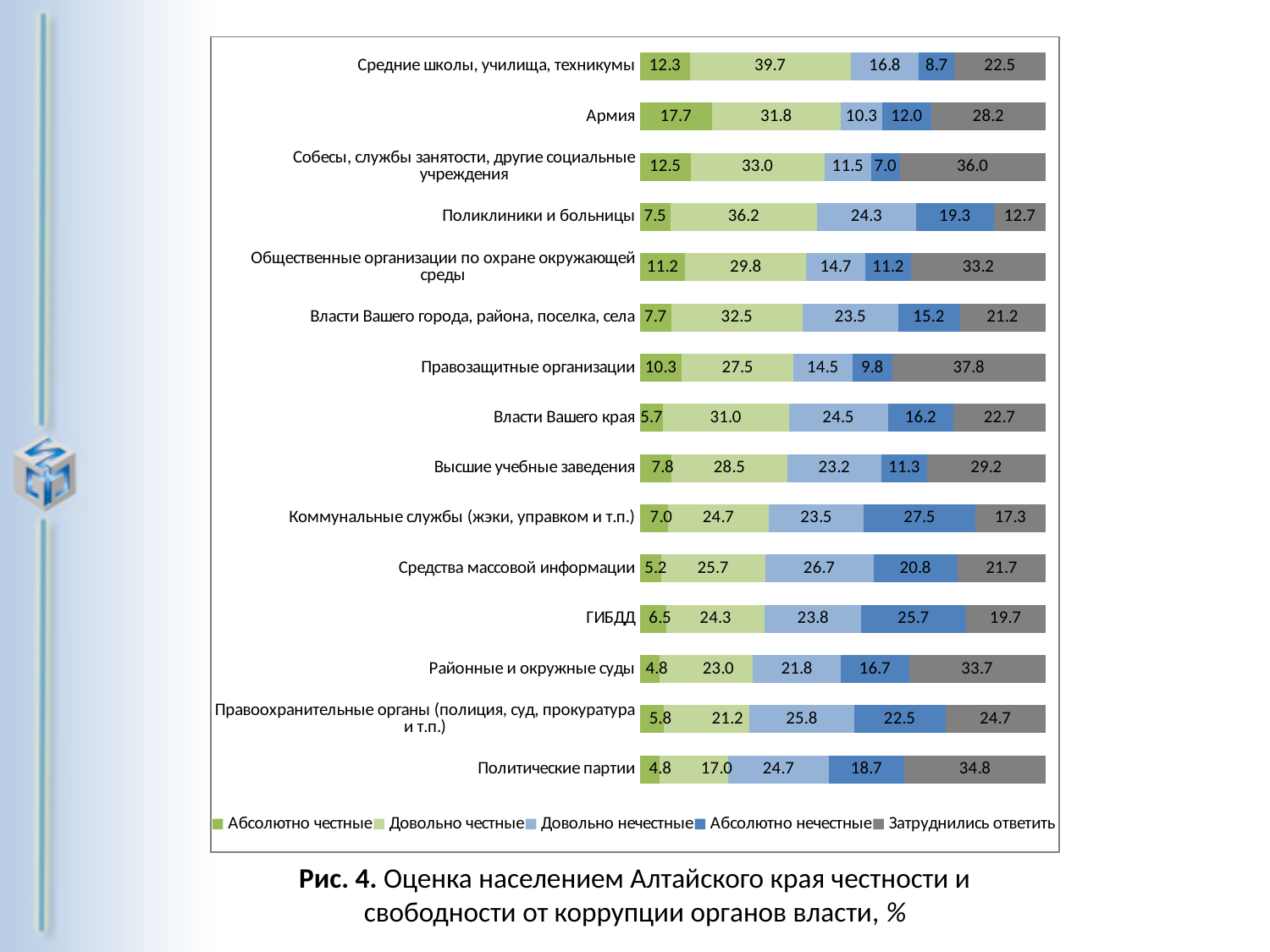
What type of chart is shown on the slide? Stacked horizontal bar chart Which is larger: the 'Абсолютно нечестные' value for 'Коммунальные службы (жэки, управком и т.п.)' or for 'Средние школы, училища, техникумы'? Коммунальные службы (жэки, управком и т.п.) Which category has the highest value for 'Абсолютно честные'? Армия What is the value of 'Абсолютно честные' for 'Армия'? 17.7 Which category has the highest value for 'Затруднились ответить'? Правозащитные организации Which category has the lowest value for 'Довольно честные'? Политические партии How many categories (organisations) are plotted in the chart? 15 How many series does the legend list? 5 What is the value of 'Затруднились ответить' for 'Политические партии'? 34.8 What is the difference between the 'Довольно честные' values for 'Средние школы, училища, техникумы' and 'Политические партии'? 22.7 What is the total of the stacked bar for 'Средние школы, училища, техникумы'? 100.0 What is the value of 'Абсолютно нечестные' for 'ГИБДД'? 25.7